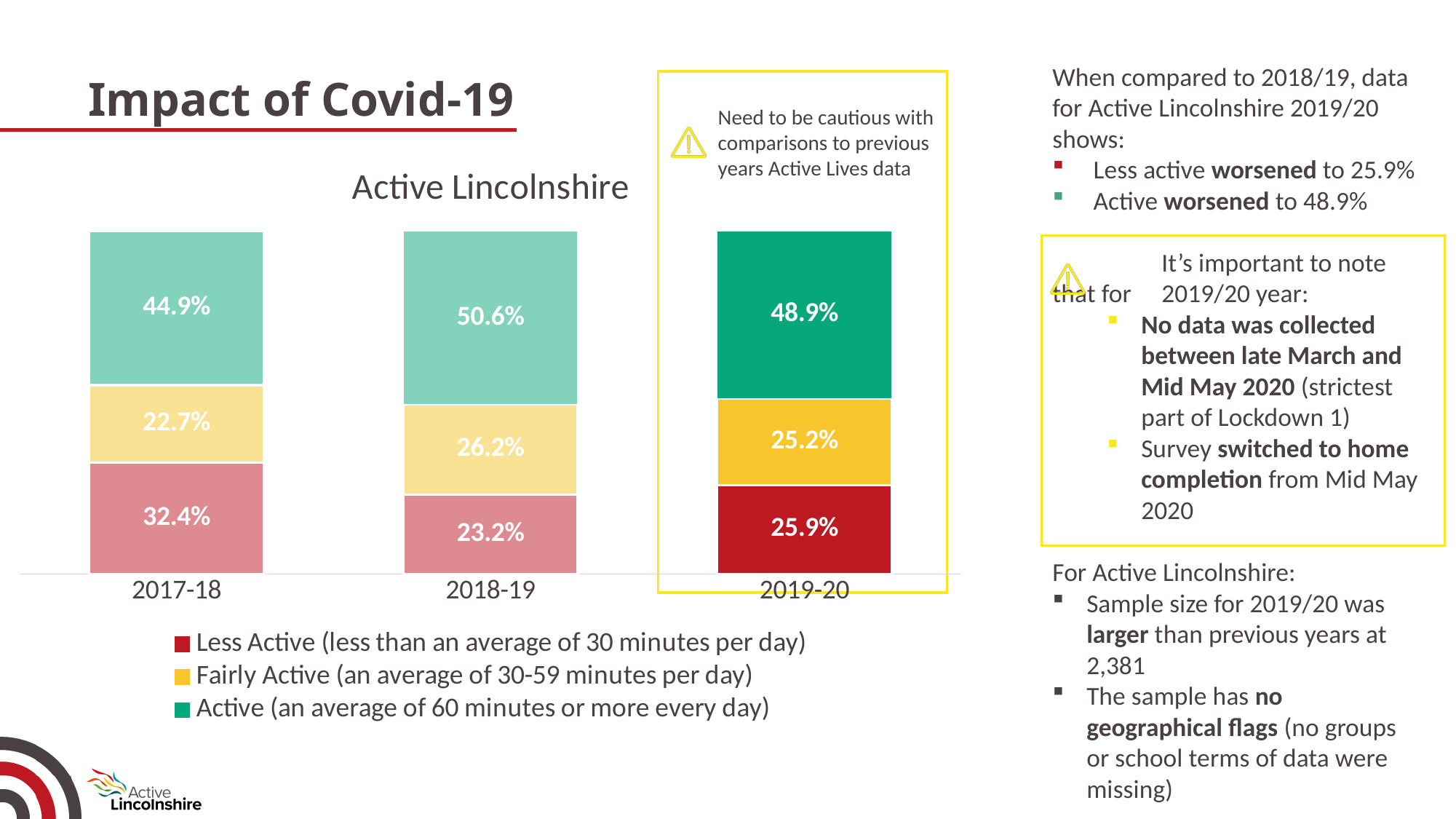
What is the difference between the Active percentage in 2018-19 and 2019-20? 1.7% What is the title of the chart? Active Lincolnshire What is the Fairly Active percentage for 2019-20? 25.2% Which year has the highest Active percentage? 2018-19 Which colour represents the Less Active series in the legend? Red What is the Active percentage for 2018-19? 50.6% What kind of chart is shown? Stacked bar chart What is the Less Active percentage for 2017-18? 32.4% Which is larger, the Fairly Active percentage in 2017-18 or in 2018-19? 2018-19 How many years are shown on the x axis? 3 How many series does the legend list? 3 Which year has the lowest Less Active percentage? 2018-19